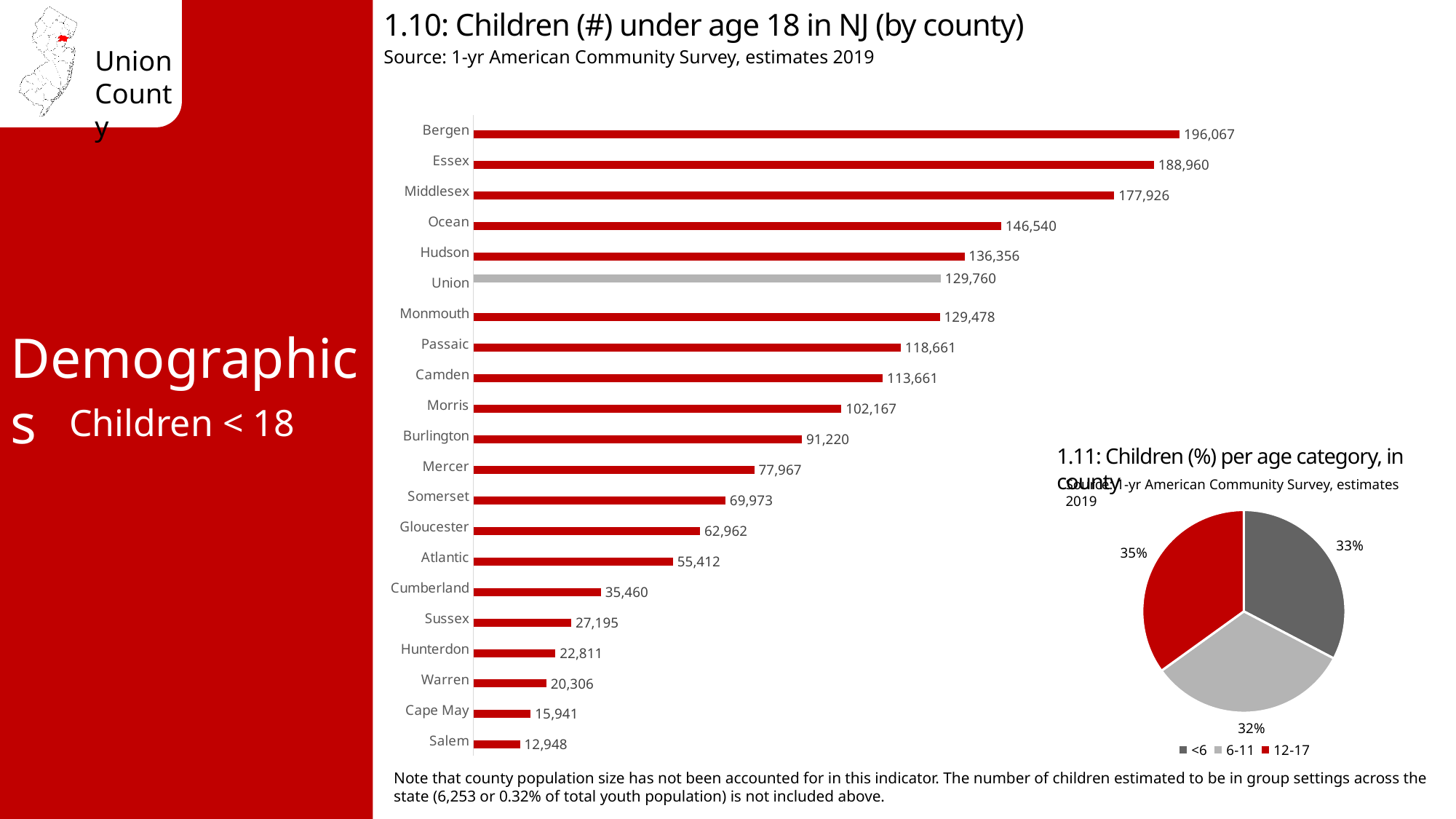
In the chart '1.10: Children (#) under age 18 in NJ (by county)', which county's bar is shown in grey instead of red? Union In the chart '1.10: Children (#) under age 18 in NJ (by county)', what is the value for Union? 129,760 In the chart '1.10: Children (#) under age 18 in NJ (by county)', what is the value for Camden? 113,661 In the chart '1.10: Children (#) under age 18 in NJ (by county)', which has a larger value, Ocean or Hudson? Ocean In the chart '1.10: Children (#) under age 18 in NJ (by county)', which county has the highest value? Bergen How many counties are shown in the chart '1.10: Children (#) under age 18 in NJ (by county)'? 21 In the pie chart '1.11: Children (%) per age category, in county', what share is the 6-11 age category? 32% In the chart '1.10: Children (#) under age 18 in NJ (by county)', what is the difference between the values for Bergen and Essex? 7,107 How many age categories does the legend of the pie chart '1.11: Children (%) per age category, in county' list? 3 In the chart '1.10: Children (#) under age 18 in NJ (by county)', which county has the lowest value? Salem In the pie chart '1.11: Children (%) per age category, in county', which age category has the largest share? 12-17 What kind of chart is '1.10: Children (#) under age 18 in NJ (by county)'? Bar chart